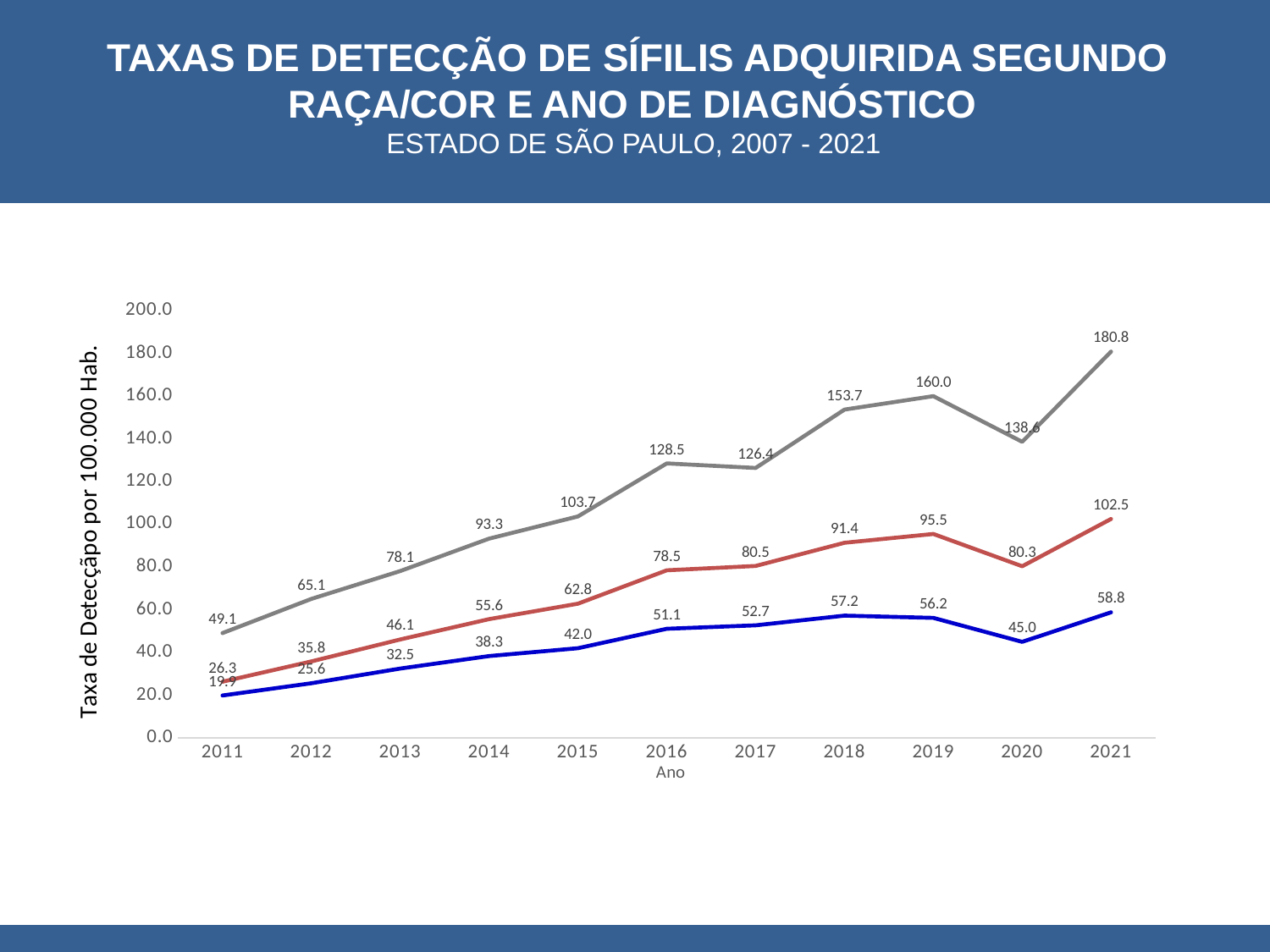
What is the label of the y axis? Taxa de Detecçãpo por 100.000 Hab. What is the value of the blue line in 2018? 57.2 How many years are shown on the x axis? 11 What kind of chart is shown on the slide? Line chart What is the difference between the gray line and the red line in 2021? 78.3 In which year does the gray line reach its highest value? 2021 In which year is the red line at its lowest value? 2011 Is the value of the gray line in 2018 greater or less than 140? greater What is the value of the gray line in 2021? 180.8 Which is larger in 2020: the red line value or the blue line value? The red line (80.3) What is the value of the gray line in 2015? 103.7 What is the value of the red line in 2019? 95.5